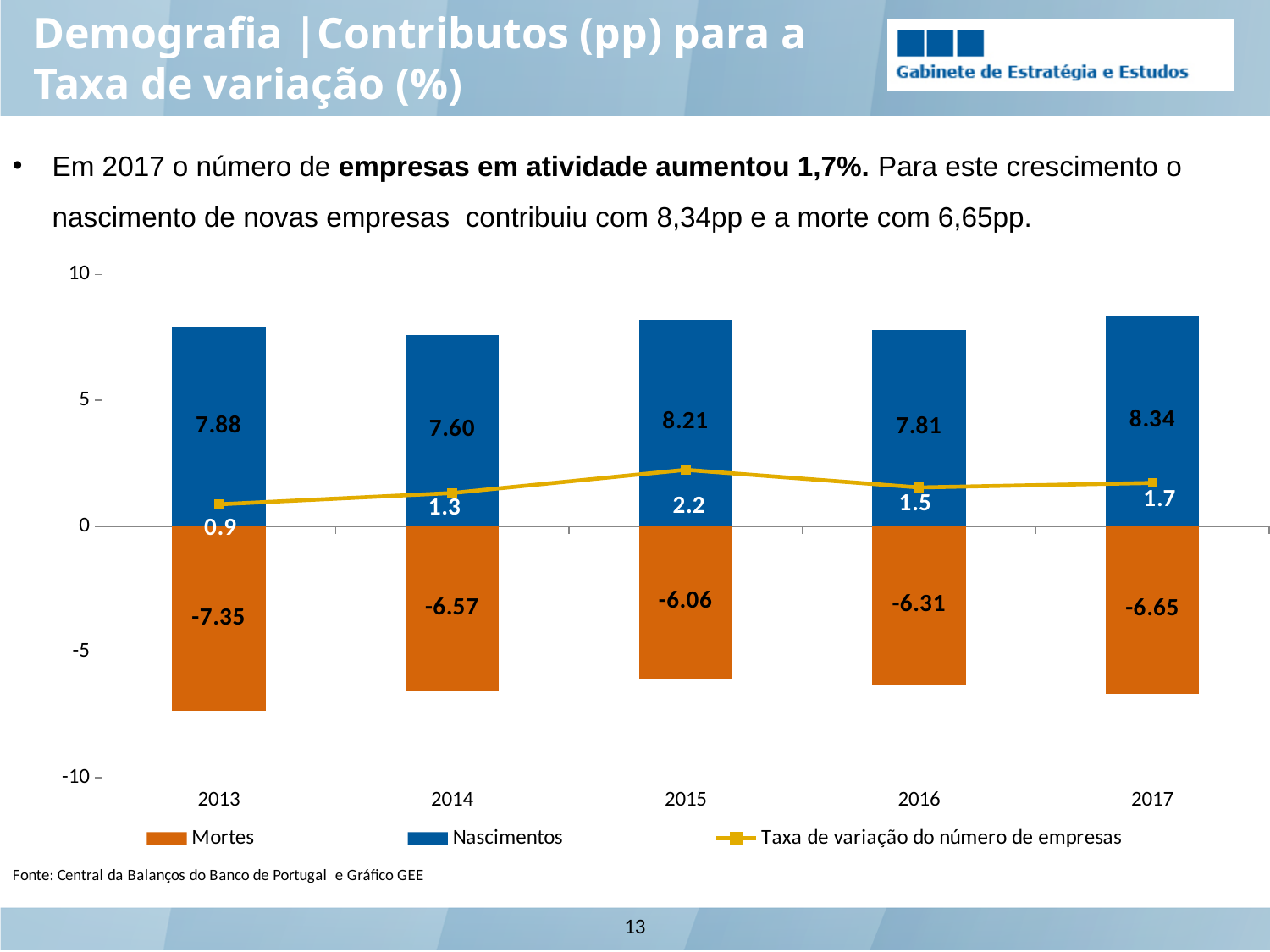
What is the value of Nascimentos for 2017? 8.34 What is the value of Mortes for 2013? -7.35 In which year is the Taxa de variação do número de empresas lowest? 2013 Is the Nascimentos value for 2015 greater or less than 5? greater Which year has a larger Nascimentos value, 2013 or 2016? 2013 What kind of chart is shown on the slide? Bar chart with a line What is the value of Taxa de variação do número de empresas for 2015? 2.2 How many series does the legend list? 3 Which series is shown in orange? Mortes In which year is the Nascimentos value highest? 2017 What is the difference between the Nascimentos values for 2015 and 2014? 0.61 How many years are shown on the x axis? 5